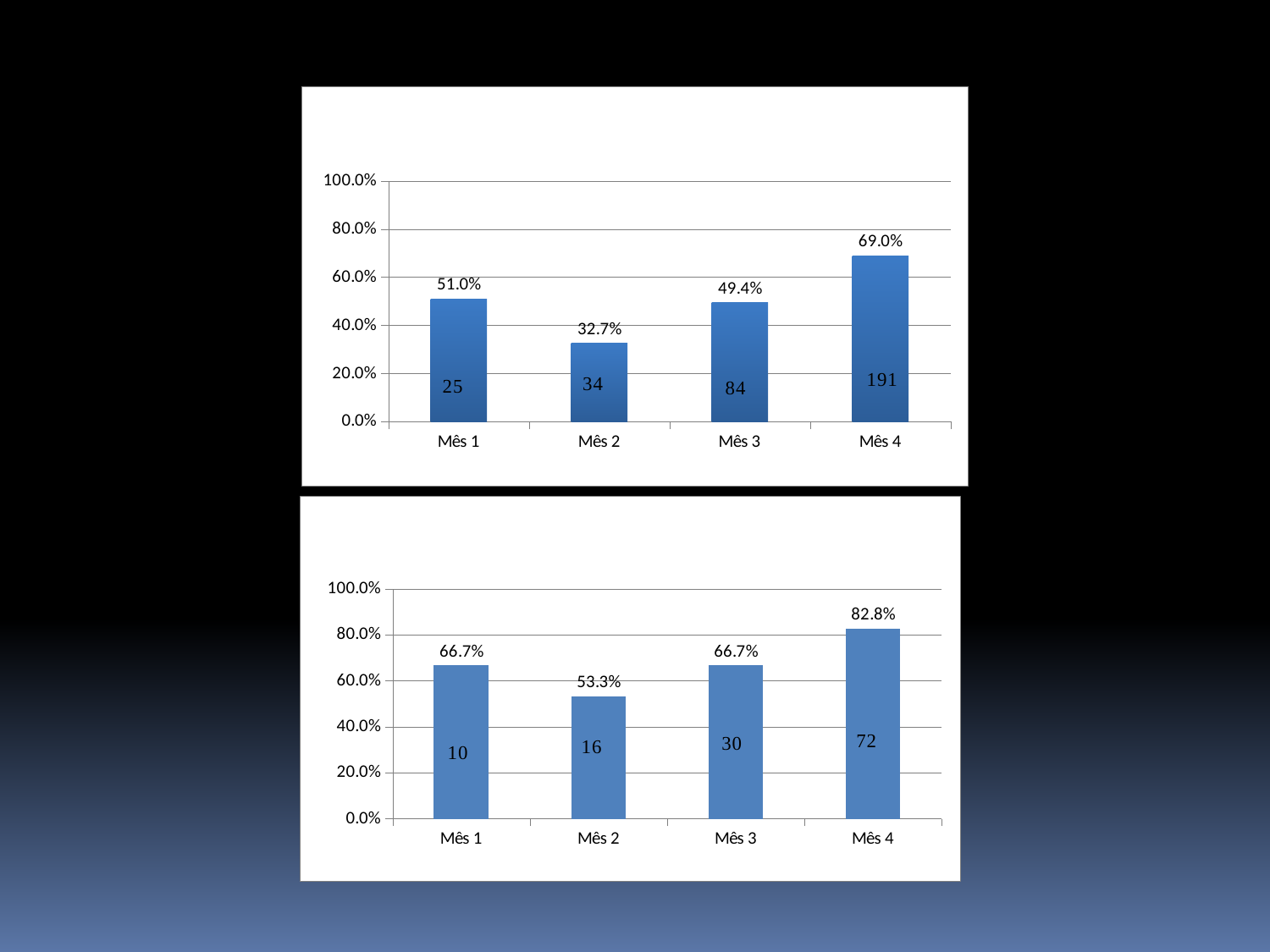
In the top chart, what is the difference between the percentages for Mês 4 and Mês 1? 18.0% In the top chart, which month has the lowest percentage? Mês 2 What kind of chart is the bottom chart? Bar chart In the bottom chart, what number is printed inside the bar for Mês 4? 72 In the bottom chart, which month has the lowest percentage? Mês 2 How many categories are shown on the x axis of the top chart? 4 In the top chart, what is the percentage value for Mês 2? 32.7% In the top chart, what number is printed inside the bar for Mês 3? 84 In the bottom chart, what is the percentage value for Mês 4? 82.8% In the bottom chart, what is the difference between the percentages for Mês 4 and Mês 2? 29.5% In the top chart, what is the percentage value for Mês 4? 69.0% In the bottom chart, which month has the highest percentage? Mês 4